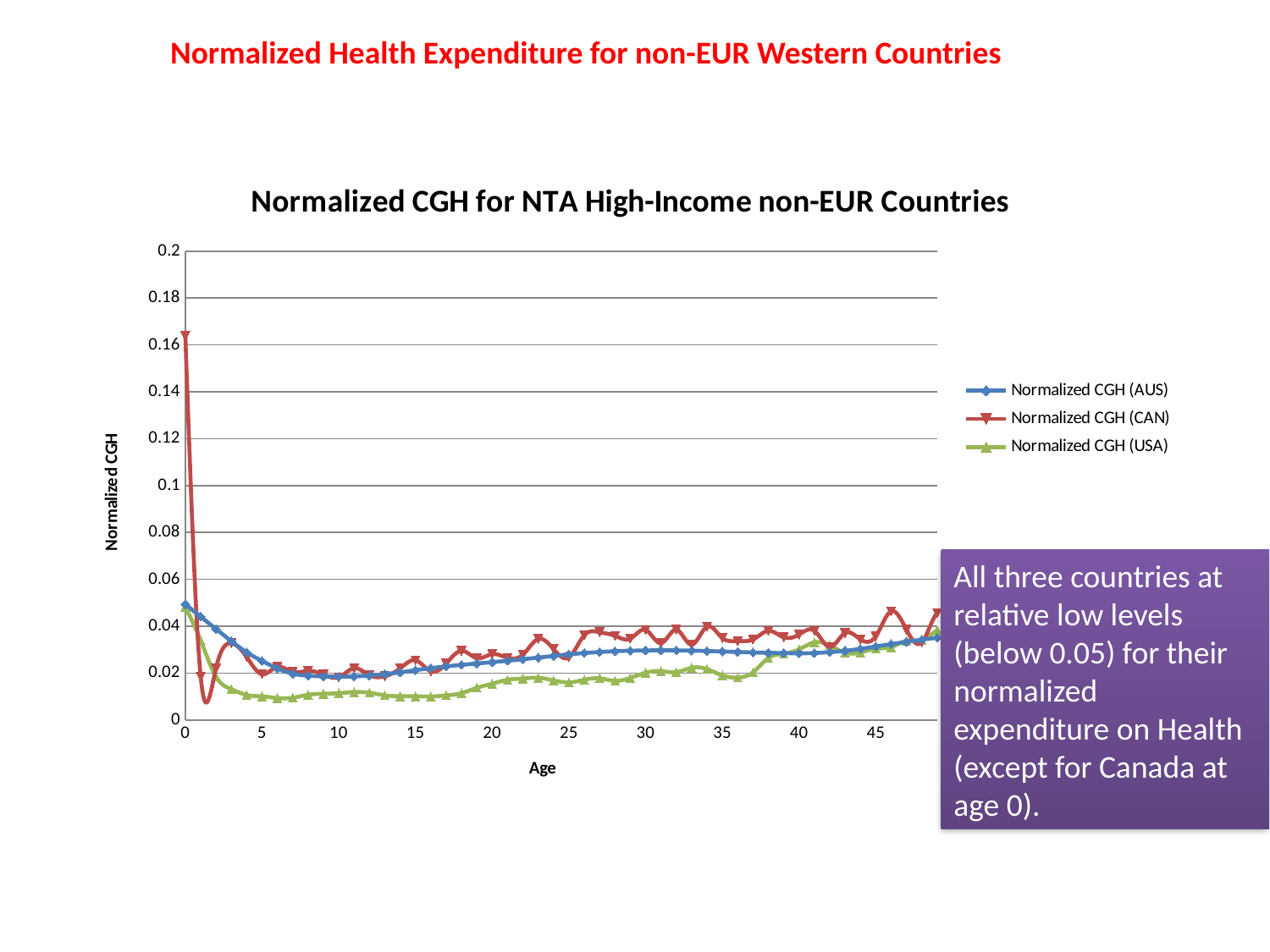
Is the value for Normalized CGH (USA) at age 15 greater or less than 0.02? less What is the label of the x axis? Age What is the title of the chart? Normalized CGH for NTA High-Income non-EUR Countries What kind of chart is shown on the slide? line chart How many series does the legend list? 3 Does the Normalized CGH (AUS) series rise or fall between age 0 and age 10? fall Is the value for Normalized CGH (CAN) at age 0 greater or less than 0.14? greater At age 15, which is larger: Normalized CGH (AUS) or Normalized CGH (USA)? Normalized CGH (AUS) Which series has the highest value at age 0? Normalized CGH (CAN) Is the value for Normalized CGH (CAN) at age 30 greater or less than 0.06? less Which series has the lowest value at age 15? Normalized CGH (USA)